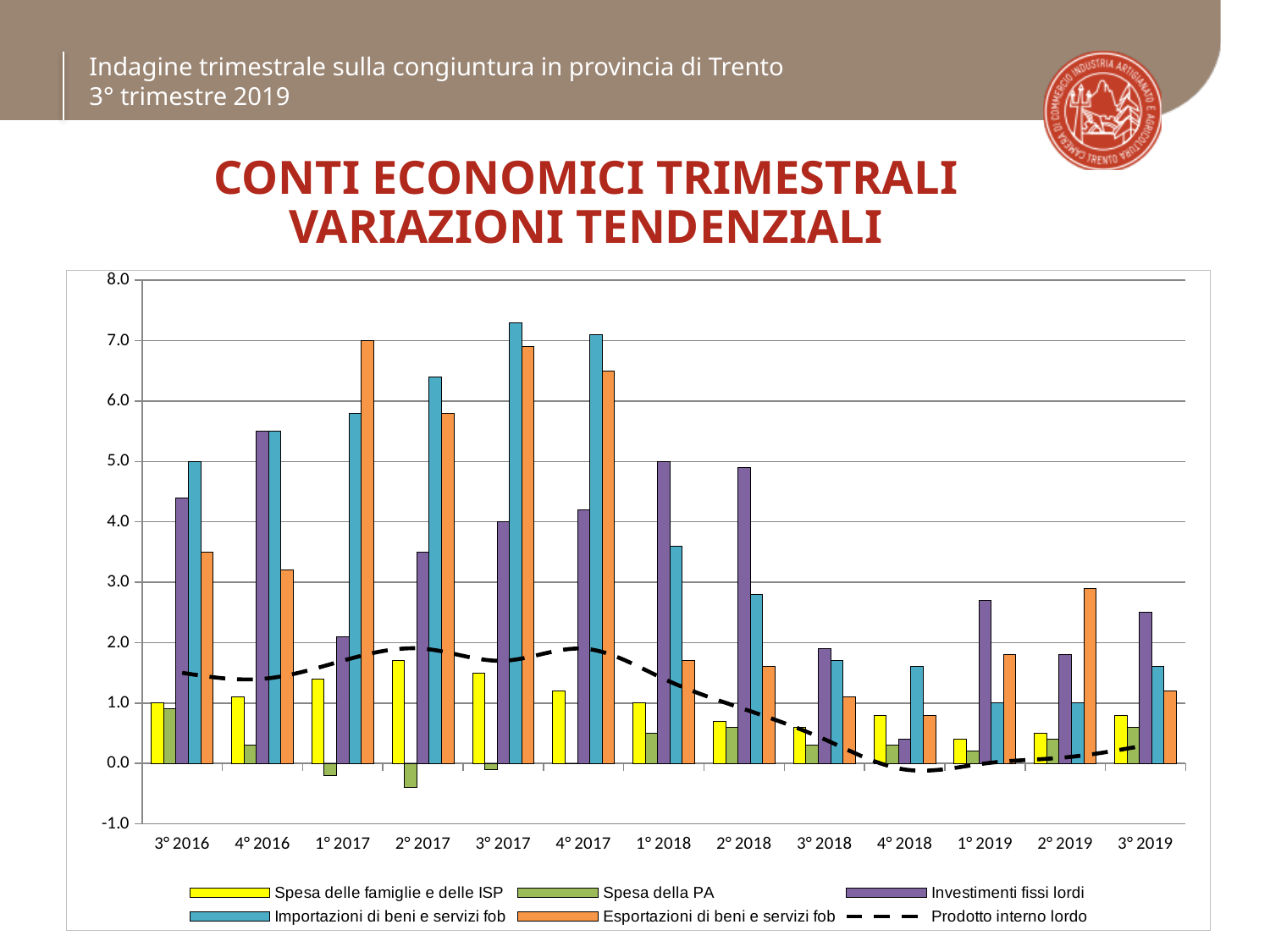
In 2° 2019, which is larger: Esportazioni di beni e servizi fob or Importazioni di beni e servizi fob? Esportazioni di beni e servizi fob Do the values for Importazioni di beni e servizi fob rise or fall from 3° 2017 to 2° 2019? fall Is the value for Esportazioni di beni e servizi fob in 2° 2019 greater or less than 2.0? greater What kind of chart is shown on the slide? combination bar and line chart What colour are the bars for Spesa delle famiglie e delle ISP? yellow Is the value for Importazioni di beni e servizi fob in 3° 2017 greater or less than 7.0? greater How many series does the legend list? 6 In which quarter is the value for Investimenti fissi lordi highest? 4° 2016 In which quarter is the value for Spesa della PA lowest? 2° 2017 Which series is drawn as a dashed line? Prodotto interno lordo In 3° 2016, which is larger: Investimenti fissi lordi or Importazioni di beni e servizi fob? Importazioni di beni e servizi fob How many quarters are shown along the x axis? 13